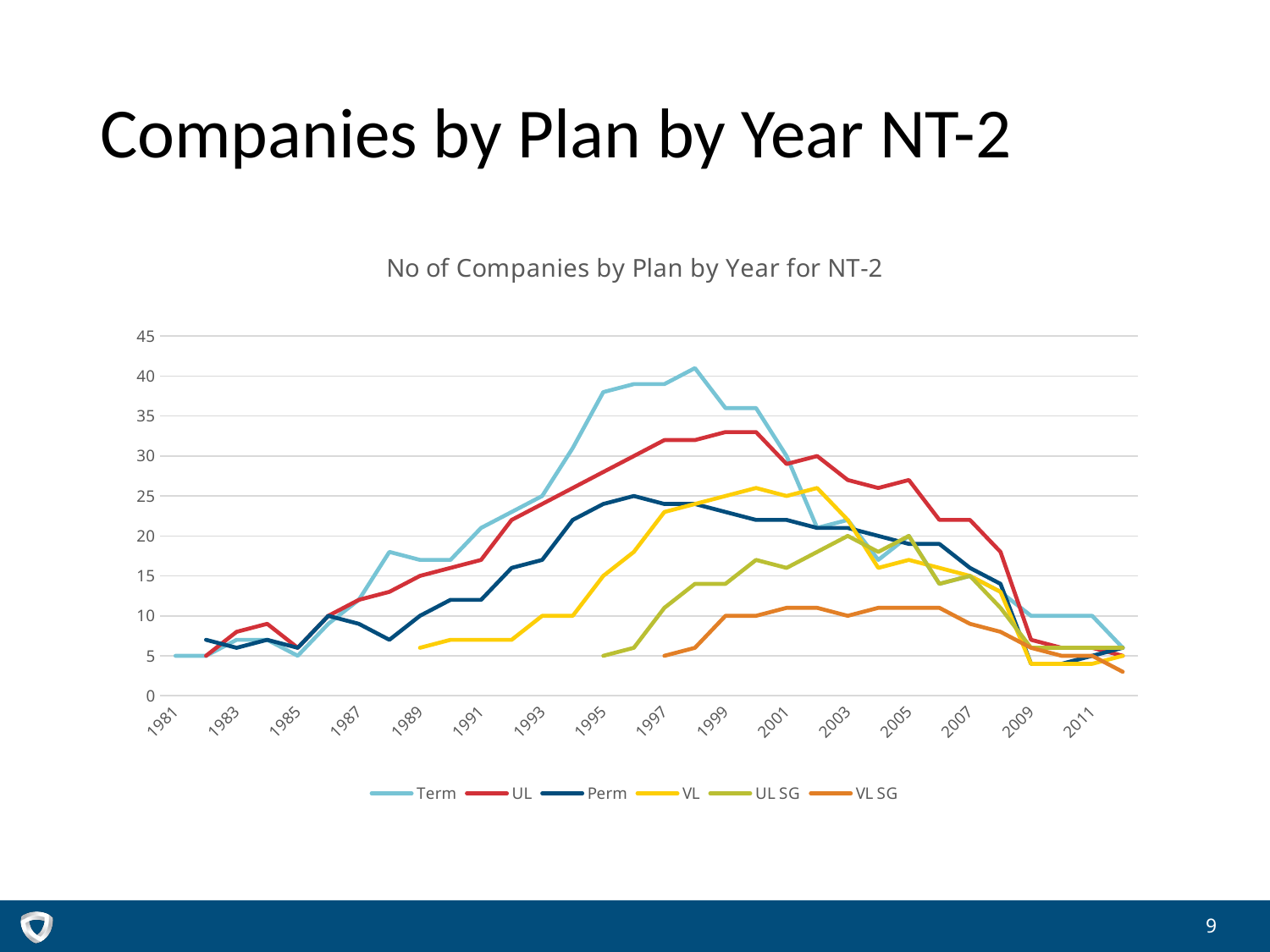
In 2005, which series has the larger value, UL or Perm? UL What kind of chart is shown on the slide? line chart Is the value for Perm in 1996 greater or less than 30? less Which series reaches the highest value anywhere on the chart? Term What is the title of the chart? No of Companies by Plan by Year for NT-2 Is the value for UL SG in 2003 greater or less than 15? greater Which series is drawn in red in the chart? UL Is the value for Term in 1997 greater or less than 35? greater How many series does the legend list? 6 Does the UL series rise or fall between 2000 and 2012? fall Which series has the lowest peak value on the chart? VL SG